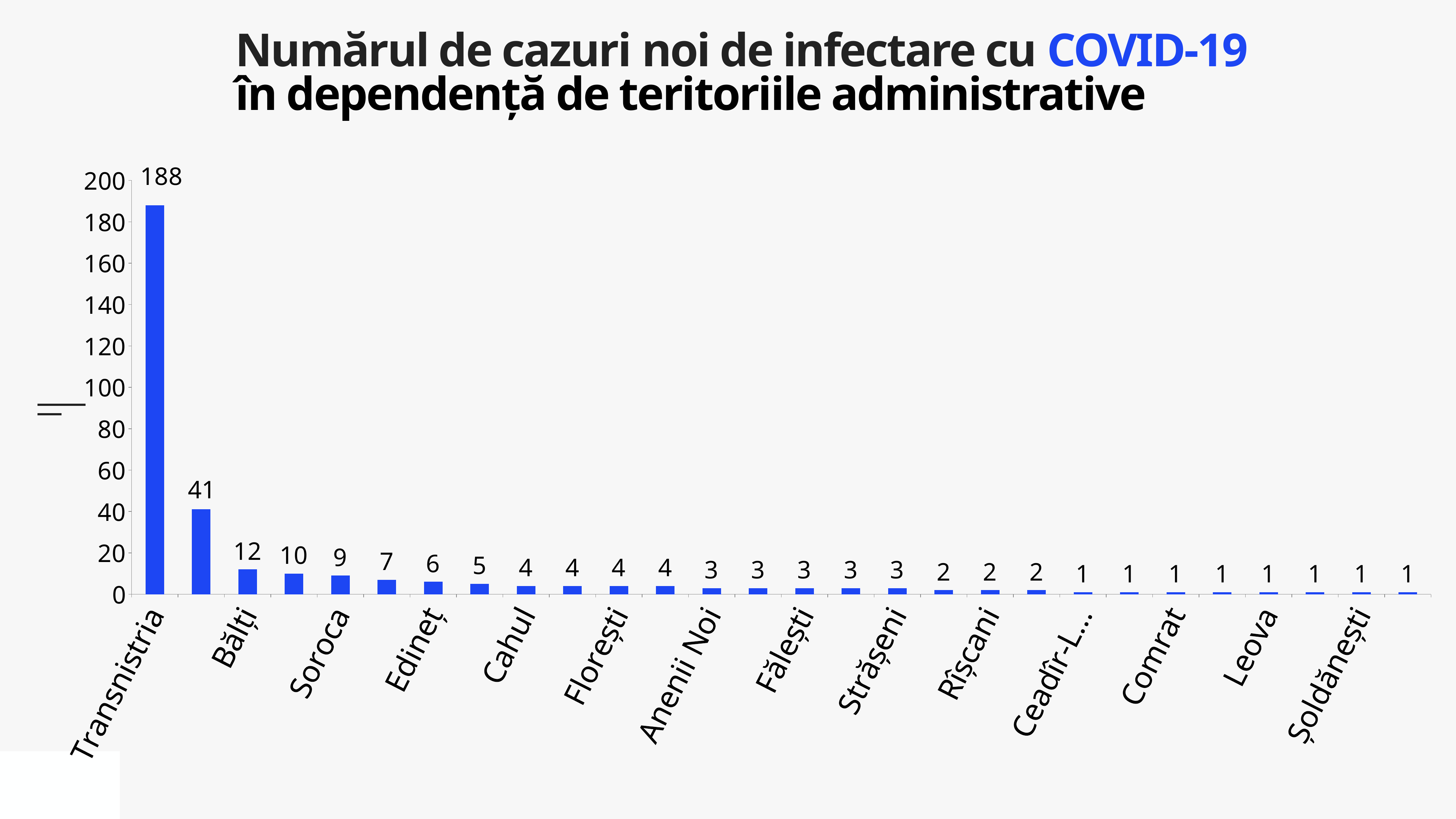
Is the value for Transnistria greater or less than 100? greater What is the value for Bălți? 12 Which is larger, the value for Soroca or the value for Edineț? Soroca Which territory has the highest number of new cases? Transnistria What is the value for Edineț? 6 What is the difference between the values for Transnistria and Bălți? 176 What is the value for Rîșcani? 2 What is the value for Soroca? 9 How many bars are plotted in the chart? 28 What is the value for Transnistria? 188 Do the values rise or fall from left to right along the x axis? fall What kind of chart is shown on the slide? bar chart